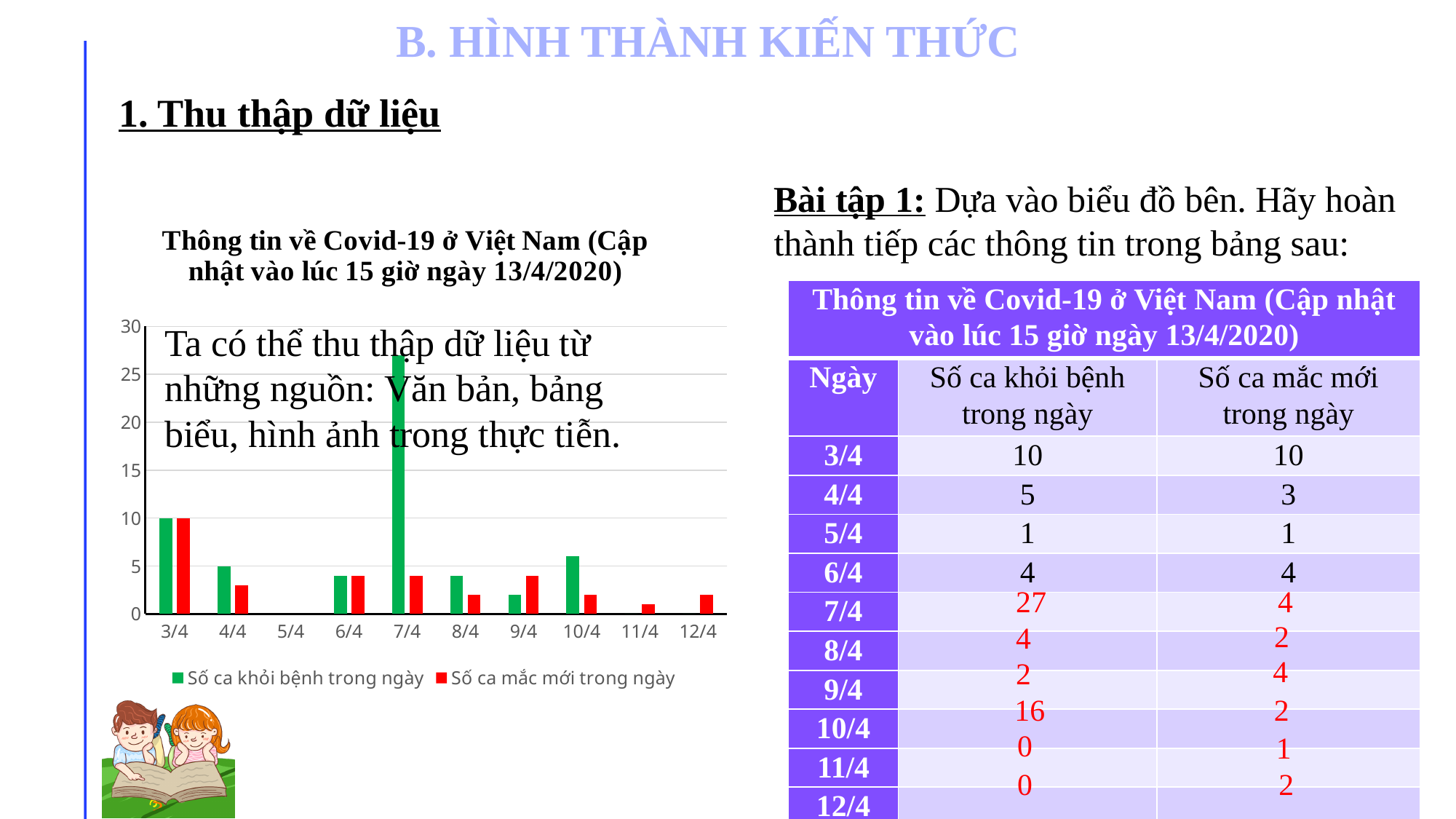
What kind of chart is shown on the slide? bar chart What is the value of 'Số ca khỏi bệnh trong ngày' on 4/4? 5 What is the value of 'Số ca khỏi bệnh trong ngày' on 3/4? 10 What is the value of 'Số ca mắc mới trong ngày' on 3/4? 10 How many series does the chart legend list? 2 How many dates are shown on the x axis of the chart? 10 On which date is 'Số ca khỏi bệnh trong ngày' highest? 7/4 What is the difference between 'Số ca khỏi bệnh trong ngày' on 3/4 and on 4/4? 5 On which date is 'Số ca mắc mới trong ngày' highest? 3/4 On 9/4, which is larger: 'Số ca khỏi bệnh trong ngày' or 'Số ca mắc mới trong ngày'? Số ca mắc mới trong ngày Is the value for 'Số ca mắc mới trong ngày' on 11/4 greater or less than 5? less Is the value for 'Số ca khỏi bệnh trong ngày' on 7/4 greater or less than 25? greater